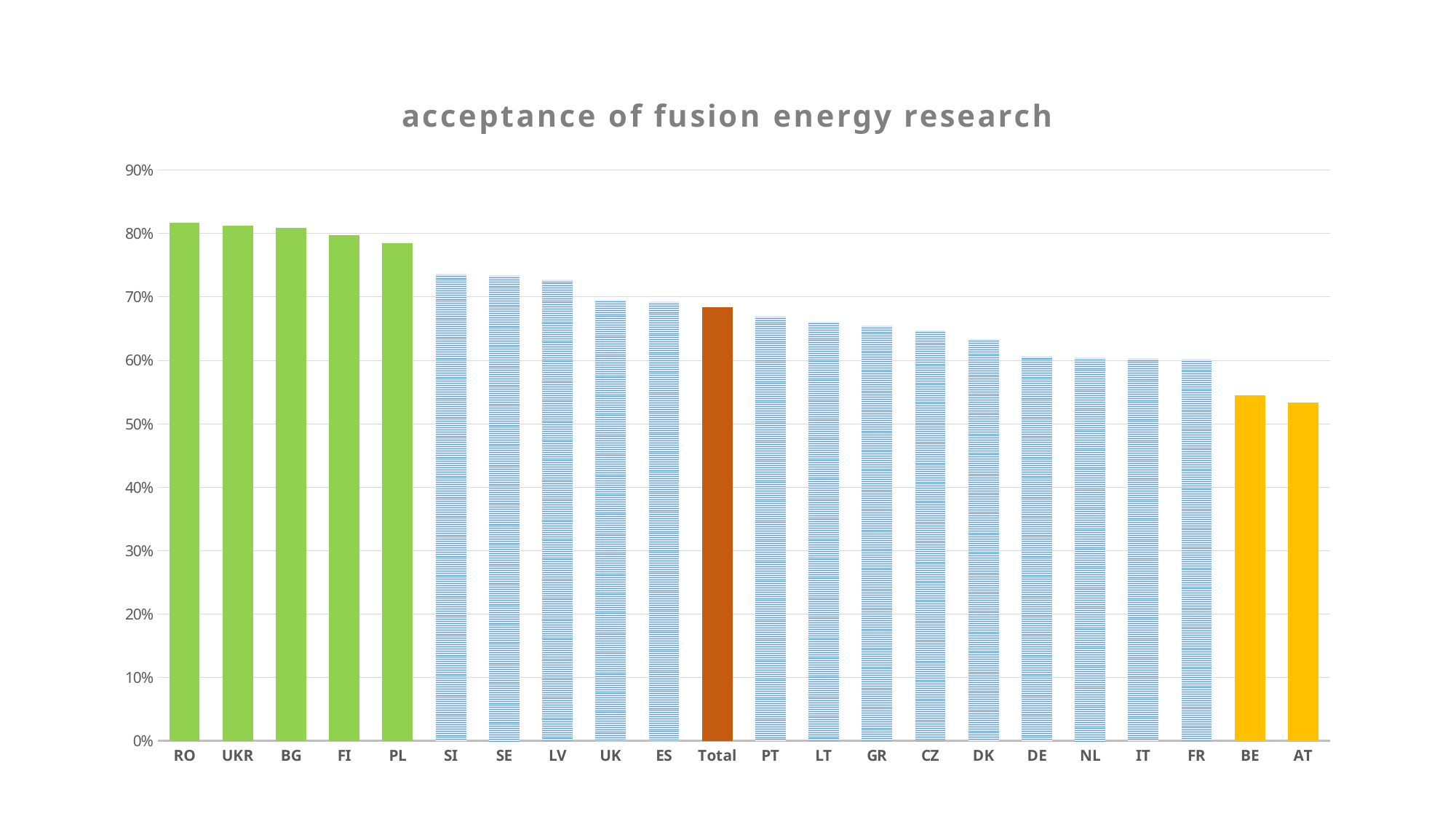
Is the value for BE greater or less than 50%? greater What is the title of the chart? acceptance of fusion energy research Do the values rise or fall moving from left to right along the x axis? fall Which is larger, the value for LV or the value for UK? LV Is the value for AT greater or less than 60%? less Is the value for RO greater or less than 80%? greater How many categories are plotted on the x axis? 22 Which is larger, the value for PL or the value for SI? PL What kind of chart is shown on the slide? bar chart